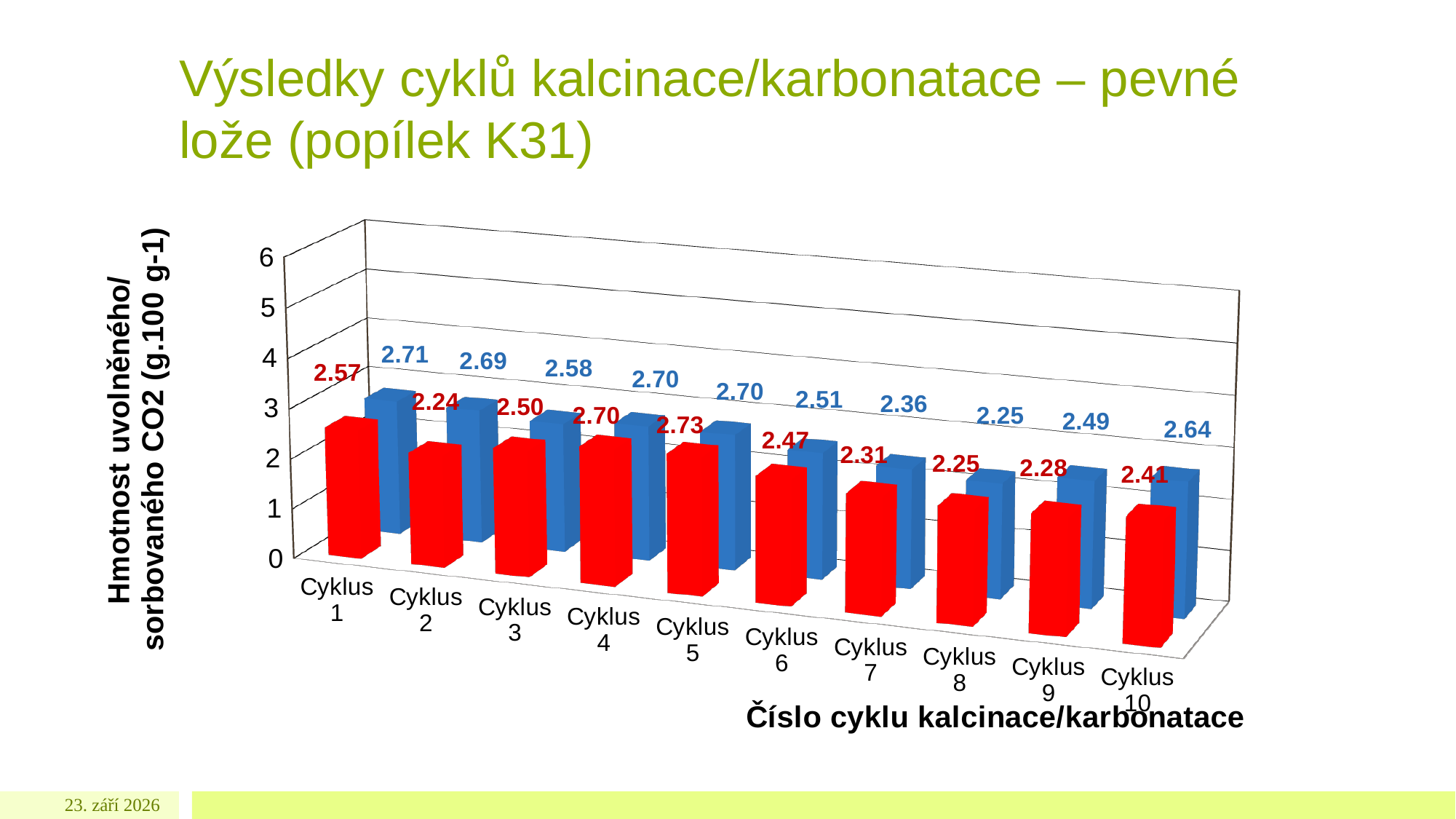
Which cycle has the lowest blue bar? Cyklus 8 What is the value of the blue bar for Cyklus 10? 2.64 For Cyklus 9, which bar is larger, the red or the blue? blue Which cycle has the lowest red bar? Cyklus 2 Which cycle has the highest red bar? Cyklus 5 How many cycles (categories) are shown on the x axis? 10 What is the value of the red bar for Cyklus 7? 2.31 What kind of chart is shown on the slide? bar chart Is the value of the blue bar for Cyklus 4 greater or less than 3? less What is the value of the red bar for Cyklus 1? 2.57 From Cyklus 5 to Cyklus 8, do the red bar values rise or fall? fall What is the difference between the red bar for Cyklus 5 and the red bar for Cyklus 2? 0.49